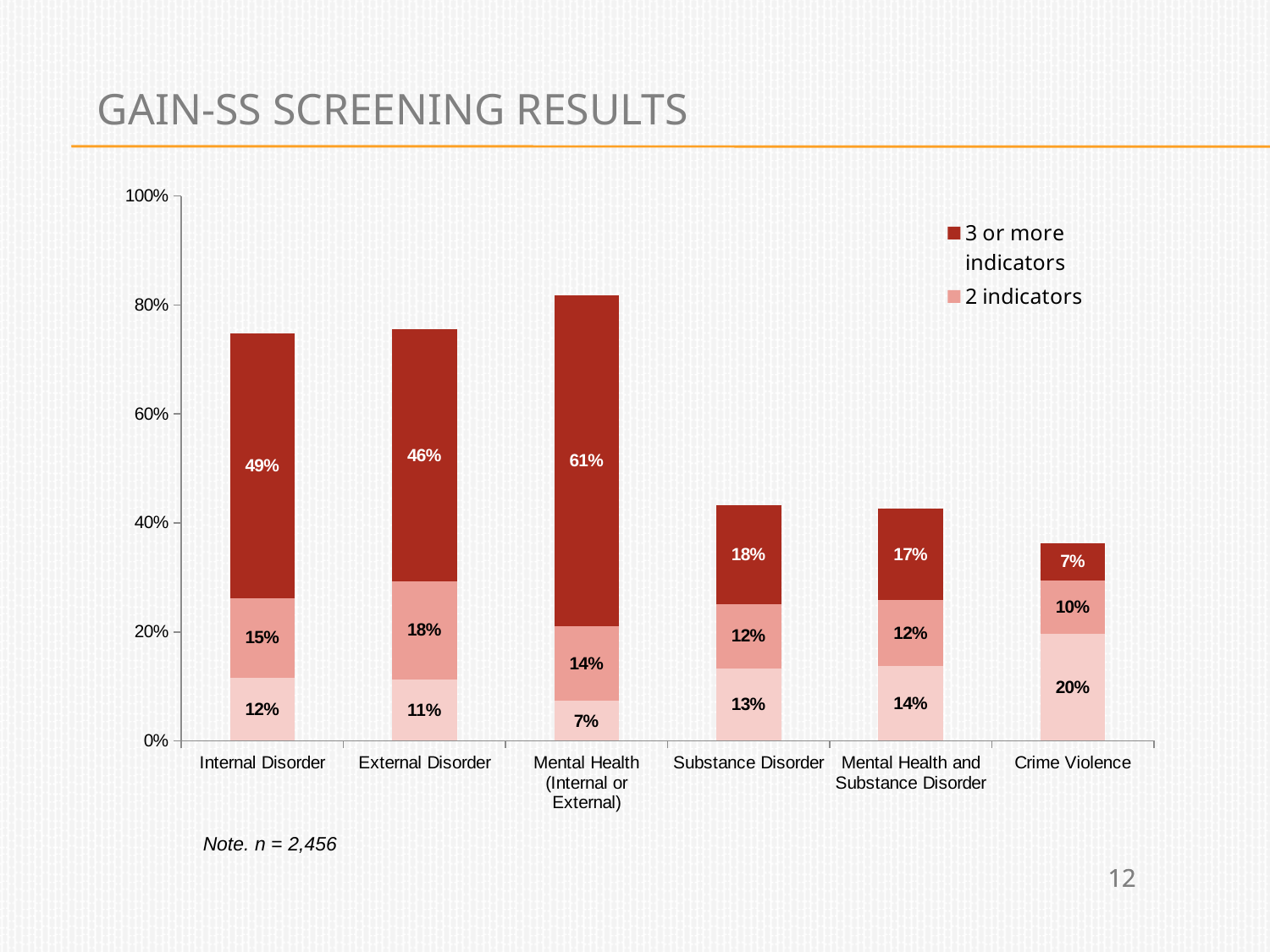
Which category has the highest value for '3 or more indicators'? Mental Health (Internal or External) What is the total of the stacked bar for Internal Disorder? 76% How many categories are shown on the x axis? 6 What kind of chart is shown on the slide? Stacked bar chart What is the value for '3 or more indicators' for Substance Disorder? 18% What is the value for '2 indicators' for External Disorder? 18% Which category has the lowest value for '3 or more indicators'? Crime Violence Which is larger: the '2 indicators' value for Internal Disorder or for Substance Disorder? Internal Disorder What is the value for '3 or more indicators' for Mental Health (Internal or External)? 61% What is the difference between the '3 or more indicators' values for Internal Disorder and External Disorder? 3% How many series does the legend list? 2 What is the title of the chart? GAIN-SS SCREENING RESULTS